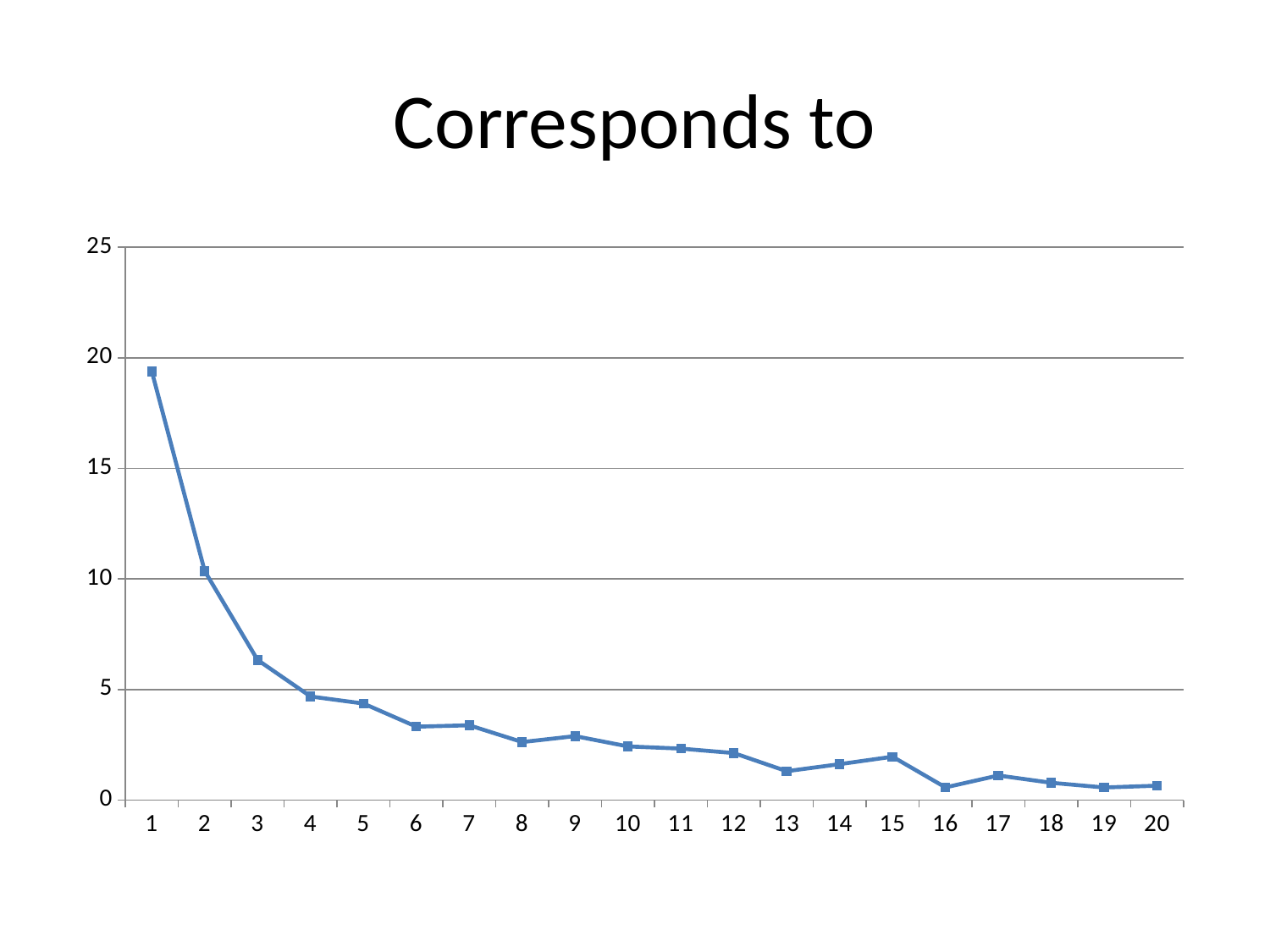
Which x-axis category has the highest value? 1 Is the value at x = 3 greater or less than 5? greater Is the value at x = 13 greater or less than 5? less What is the title of the slide containing the chart? Corresponds to What kind of chart is shown on the slide? line chart Is the value at x = 1 greater or less than 15? greater Which has the larger value, x = 1 or x = 2? 1 How many points are plotted along the x axis? 20 Do the values generally rise or fall as the x axis goes from 1 to 20? fall Which has the larger value, x = 3 or x = 10? 3